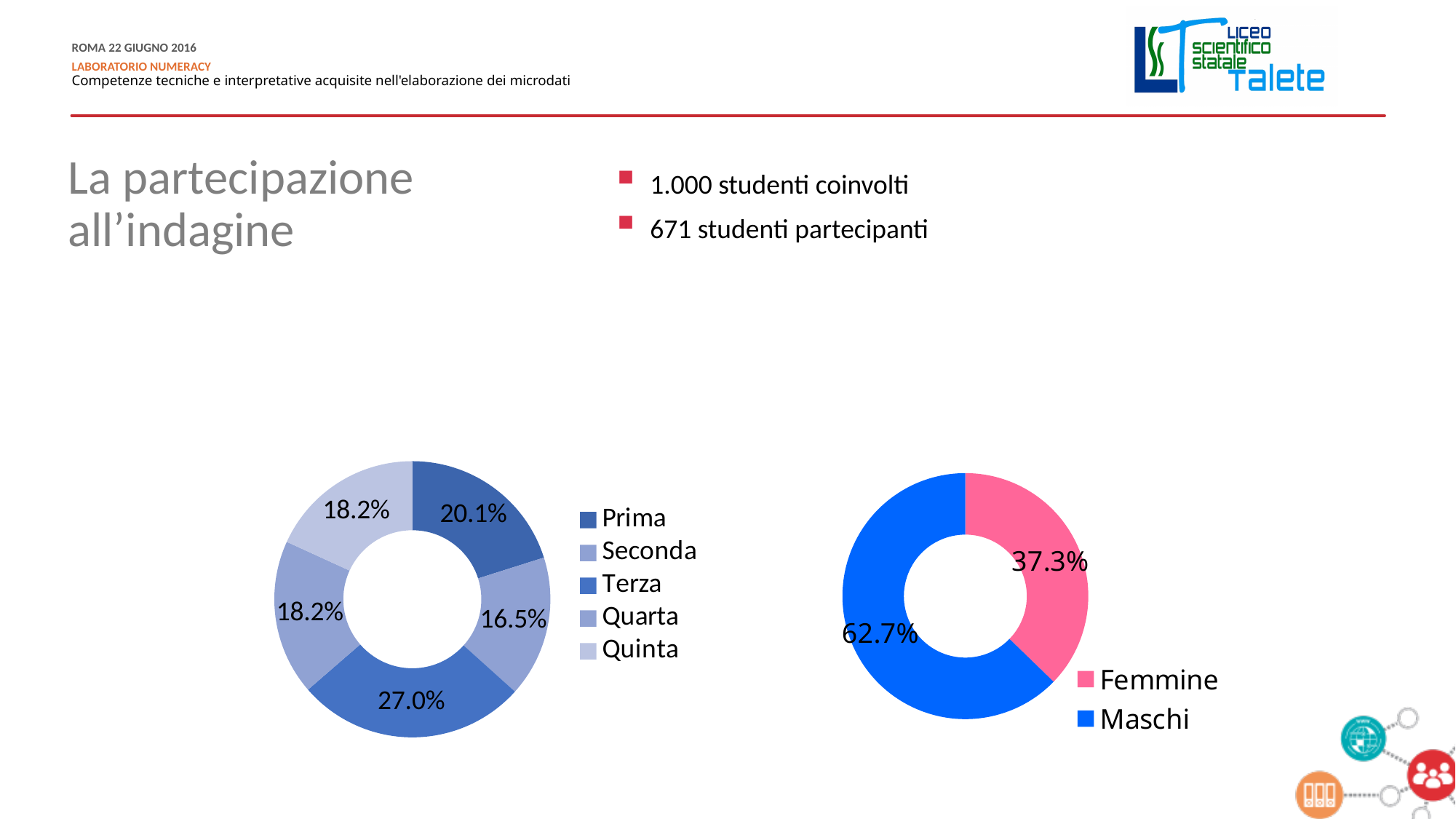
How many categories does the left doughnut chart show? 5 In the left doughnut chart, which class year has the largest share? Terza In the right doughnut chart, what percentage is shown for Femmine? 37.3% What type of chart is the right chart on the slide? Doughnut (pie) chart In the right doughnut chart, what percentage is shown for Maschi? 62.7% In the left doughnut chart, what percentage is shown for Prima? 20.1% In the right doughnut chart, what is the difference between the shares of Maschi and Femmine? 25.4% In the left doughnut chart, what percentage is shown for Seconda? 16.5% In the left doughnut chart, what percentage is shown for Terza? 27.0% In the left doughnut chart, what is the difference between the shares of Terza and Seconda? 10.5% In the left doughnut chart, which class year has the smallest share? Seconda In the left doughnut chart, which is larger, the share of Prima or the share of Seconda? Prima